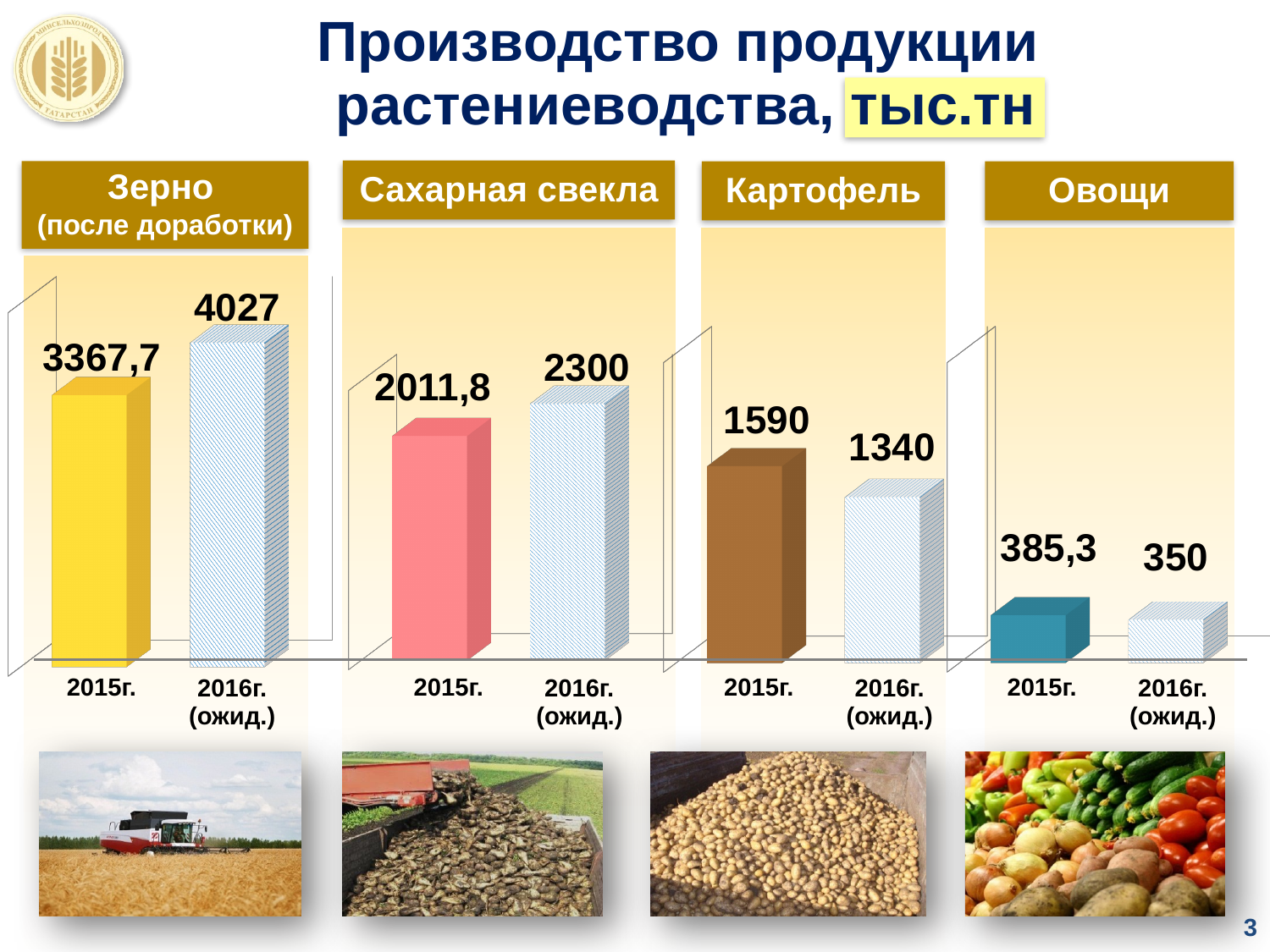
In the "Картофель" chart, what is the expected value for 2016г. (ожид.)? 1340 In the "Зерно (после доработки)" chart, what is the value for 2015г.? 3367,7 In the "Картофель" chart, what is the difference between the 2015г. and 2016г. (ожид.) values? 250 How many charts are shown on the slide? 4 In the "Сахарная свекла" chart, what is the value for 2015г.? 2011,8 In the "Зерно (после доработки)" chart, by how much does the 2016г. (ожид.) value exceed the 2015г. value? 659,3 In the "Картофель" chart, which year has the higher value? 2015г. In the "Сахарная свекла" chart, which year has the larger value, 2015г. or 2016г. (ожид.)? 2016г. (ожид.) In the "Зерно (после доработки)" chart, what is the expected value for 2016г. (ожид.)? 4027 In the "Овощи" chart, does the value rise or fall from 2015г. to 2016г. (ожид.)? fall In the "Овощи" chart, what is the value for 2015г.? 385,3 What type of chart is used for "Сахарная свекла"? bar chart